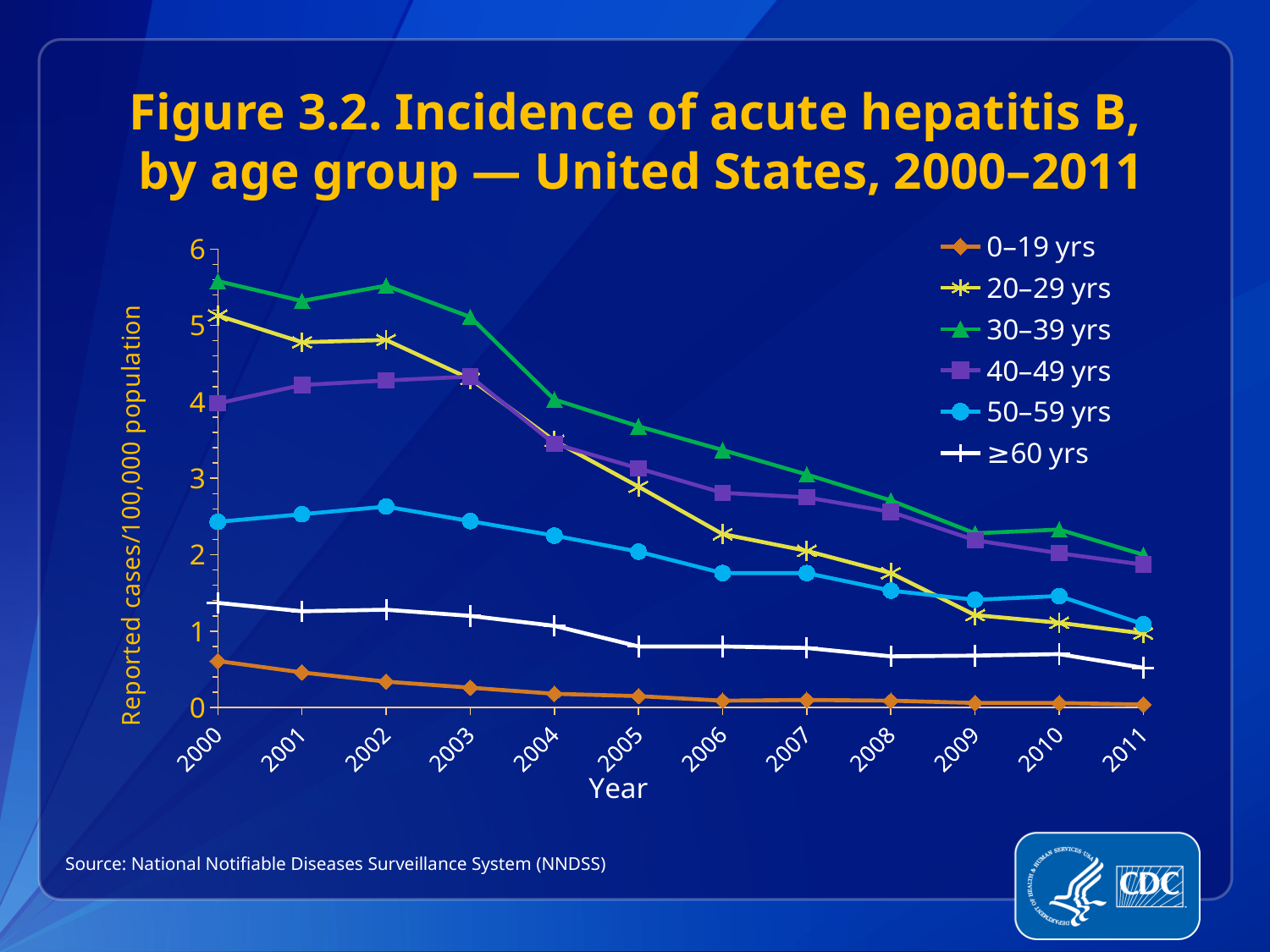
How many age-group series does the legend list? 6 What kind of chart is shown on the slide? line chart Is the value for 30–39 yrs in 2000 greater or less than 5? greater Which age group has the lowest incidence in 2000? 0–19 yrs How many years are plotted along the x axis? 12 Is the value for 50–59 yrs in 2000 greater or less than 2? greater What is the label of the y axis? Reported cases/100,000 population Does the incidence for 30–39 yrs generally rise or fall from 2000 to 2011? fall Is the value for 0–19 yrs in 2000 greater or less than 1? less Which age group has the highest incidence in 2000? 30–39 yrs In 2005, which is larger: the value for 30–39 yrs or the value for 40–49 yrs? 30–39 yrs